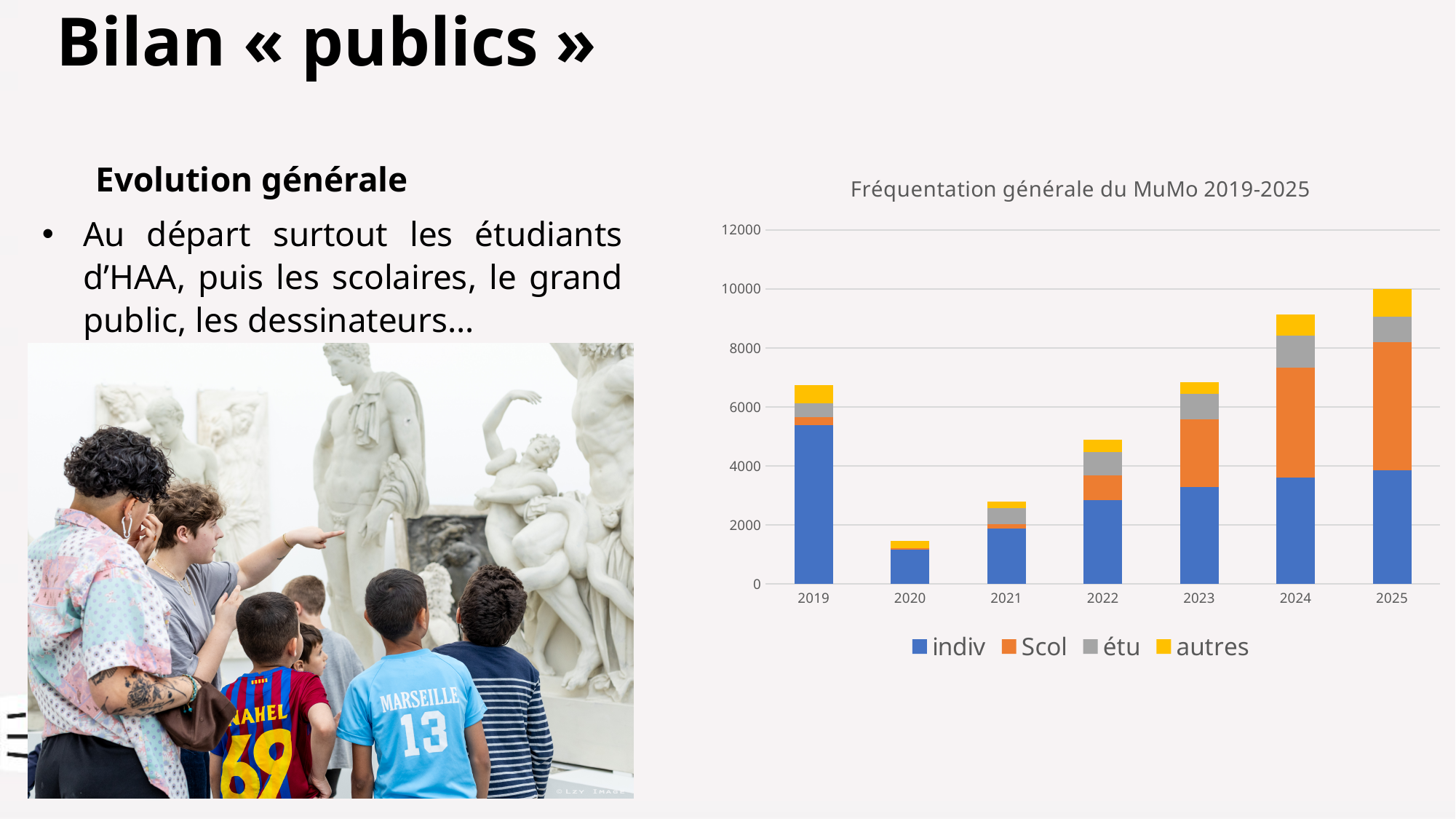
What is the title of the chart? Fréquentation générale du MuMo 2019-2025 How many series does the chart legend list? 4 What kind of chart is shown on the slide? Stacked bar chart Which year has the highest total attendance in the chart? 2025 Is the total attendance for 2021 greater or less than 4000? less Is the value for indiv in 2019 greater or less than 4000? greater Which year has the lowest total attendance in the chart? 2020 Is the total attendance for 2024 greater or less than 8000? greater How many years are shown on the x axis of the chart? 7 Does the total attendance rise or fall from 2020 to 2025? rise Which year has the larger total attendance, 2023 or 2024? 2024